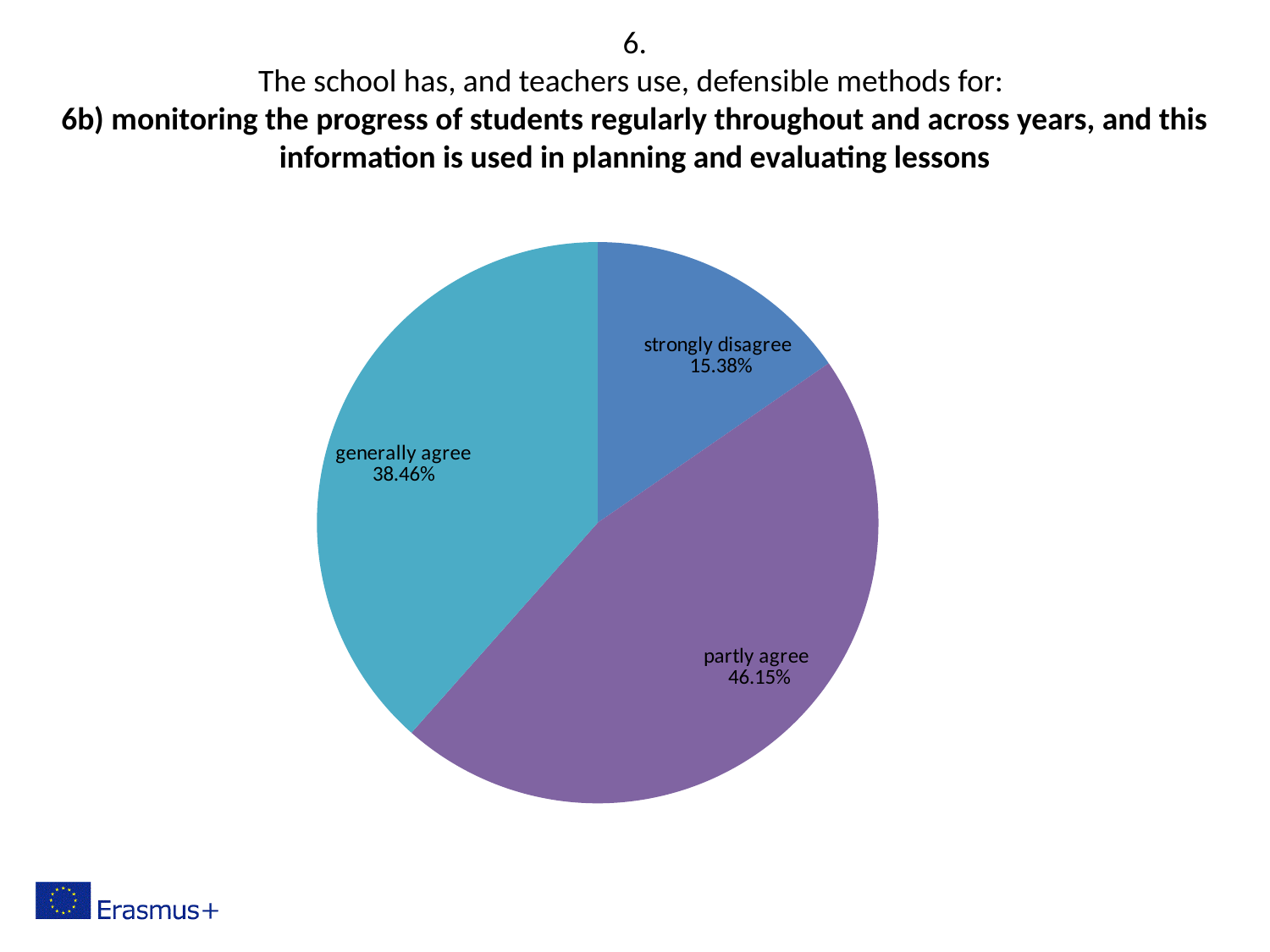
What is the difference in percentage points between "partly agree" and "generally agree"? 7.69 Which colour is used for the "partly agree" slice? purple What percentage of respondents chose "generally agree"? 38.46% What kind of chart is shown on the slide? pie chart Which response category has the smallest share of the pie? strongly disagree What percentage of respondents chose "strongly disagree"? 15.38% How many slices does the pie chart have? 3 What percentage of respondents chose "partly agree"? 46.15% Which is larger, the share for "generally agree" or the share for "strongly disagree"? generally agree Which response category has the largest share of the pie? partly agree What is the difference in percentage points between "generally agree" and "strongly disagree"? 23.08 What is the combined share of "partly agree" and "generally agree"? 84.61%